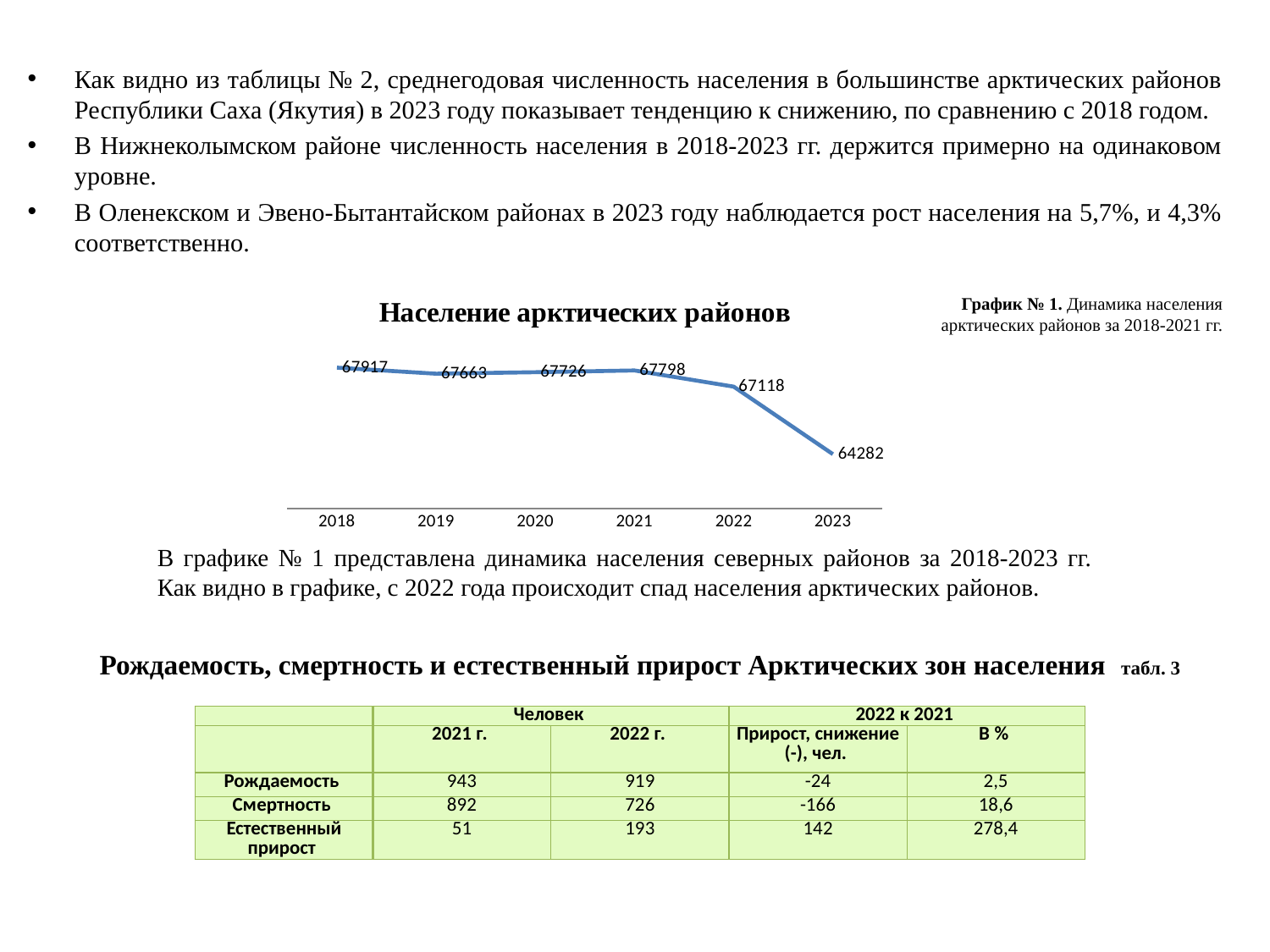
Which year has the highest value in the chart "Население арктических районов"? 2018 What type of chart is "Население арктических районов"? line chart What is the difference between the 2022 and 2023 values in the chart "Население арктических районов"? 2836 What is the value for 2020 in the chart "Население арктических районов"? 67726 What is the value for 2018 in the chart "Население арктических районов"? 67917 What is the difference between the 2018 and 2019 values in the chart "Население арктических районов"? 254 How many years are plotted in the chart "Население арктических районов"? 6 What is the value for 2023 in the chart "Население арктических районов"? 64282 Which year has the lowest value in the chart "Население арктических районов"? 2023 What is the value for 2022 in the chart "Население арктических районов"? 67118 In the chart "Население арктических районов", which is larger, the value for 2021 or the value for 2022? 2021 Do the values in the chart "Население арктических районов" rise or fall from 2021 to 2023? fall